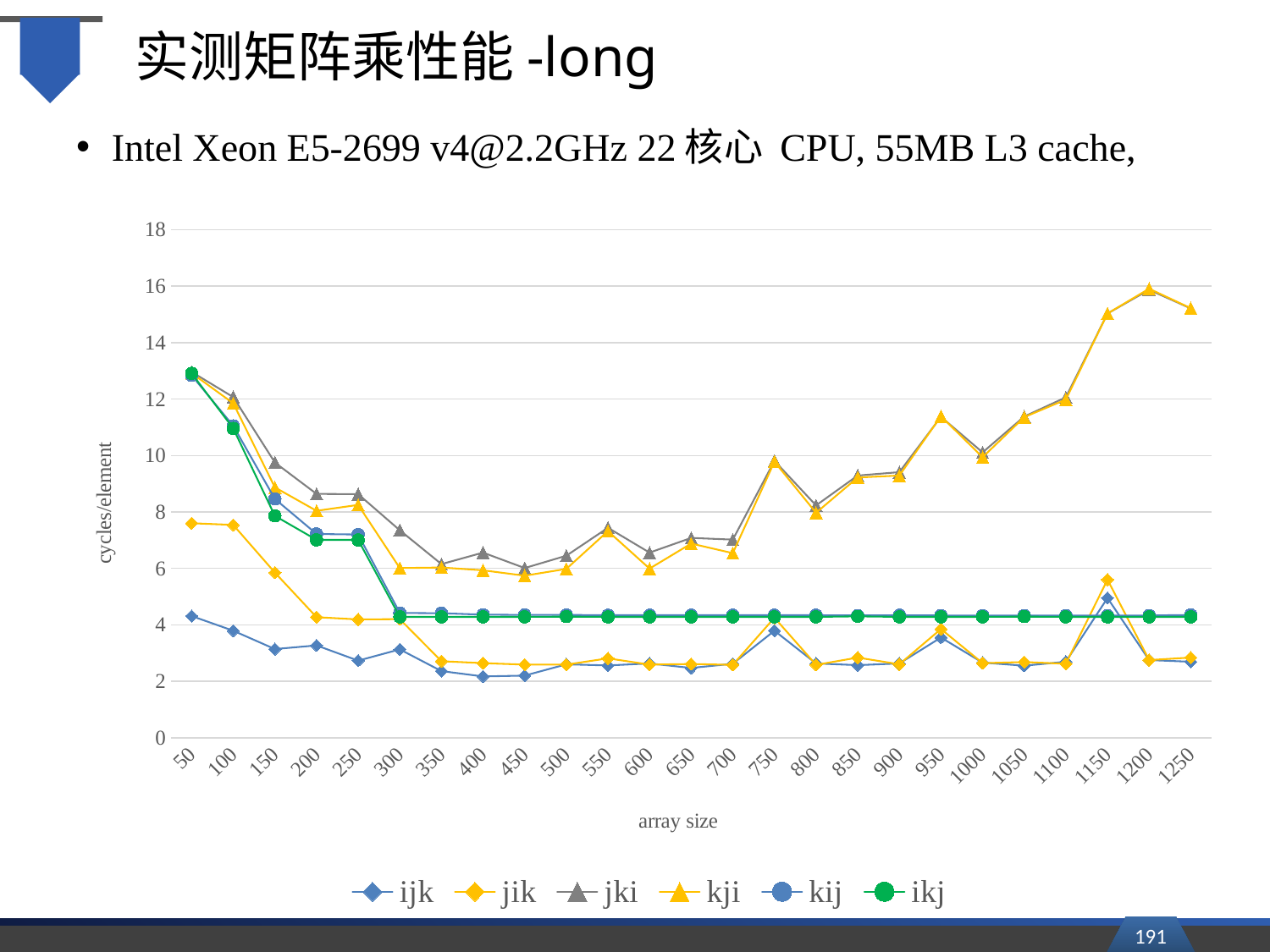
Which series has the lowest value at array size 50? ijk Is the value for ijk at array size 400 greater or less than 4? less Is the value for jki at array size 50 greater or less than 12? greater What is the label of the y axis? cycles/element Does the kji series generally rise or fall from array size 700 to 1150? rise How many array size values are plotted along the x axis? 25 Is the value for ikj at array size 1000 greater or less than 6? less How many series does the legend list? 6 What kind of chart is shown on the slide? line chart At array size 50, which is larger, jki or jik? jki What is the label of the x axis? array size